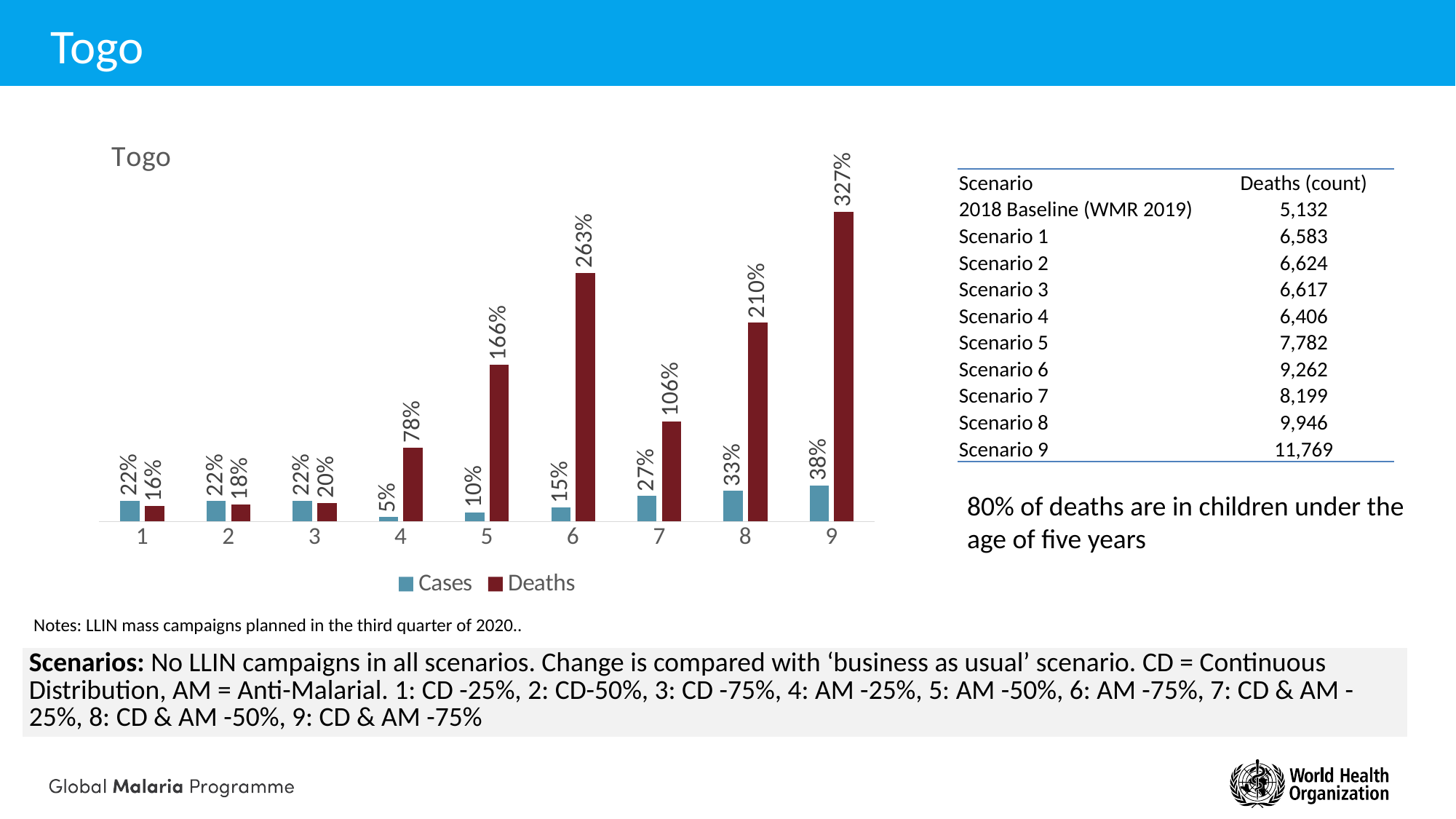
Which scenario has the highest Deaths value? 9 How many series does the chart legend list? 2 What kind of chart is shown on the slide? bar chart What is the Deaths value for scenario 6? 263% Which is larger, the Cases value for scenario 1 or the Deaths value for scenario 1? Cases Do the Deaths values rise or fall from scenario 7 to scenario 9? rise What is the Deaths value for scenario 9? 327% What is the Cases value for scenario 4? 5% How many scenarios are shown on the x axis of the chart? 9 What is the difference between the Deaths values for scenario 8 and scenario 7? 104% What is the title of the chart? Togo Which scenario has the lowest Cases value? 4